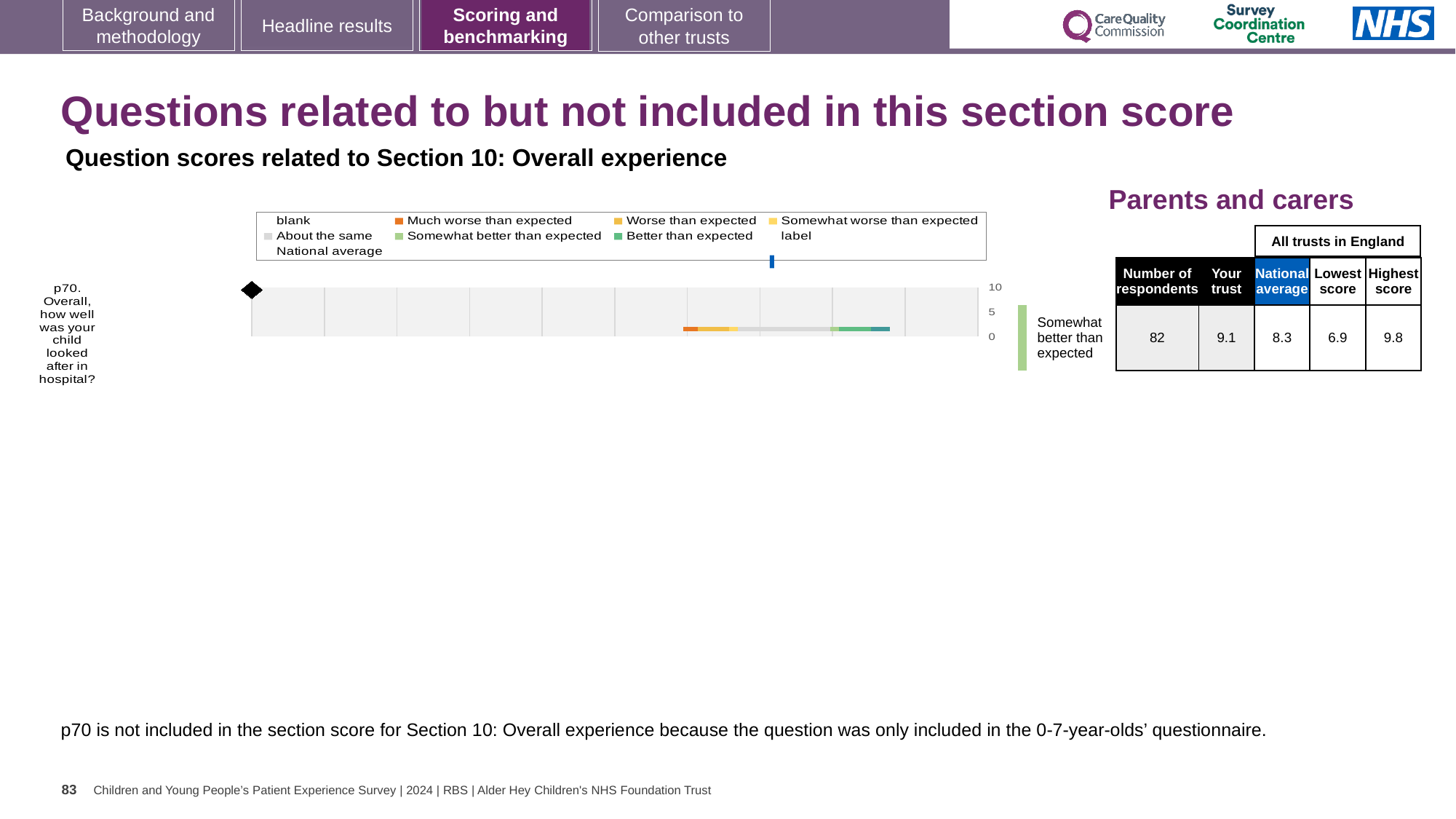
What benchmark category label is shown to the right of the p70 bar? Somewhat better than expected What is the Lowest score across all trusts in England for p70? 6.9 How many survey questions are plotted in the chart? 1 What is the Highest score across all trusts in England for p70? 9.8 What is the 'Your trust' score for p70 in the Parents and carers table? 9.1 How many respondents answered p70 in the Parents and carers table? 82 For p70, what is the difference between the 'Your trust' score and the National average? 0.8 What is the National average score for p70 in the Parents and carers table? 8.3 What kind of chart is shown for question p70? bar chart For p70, which is higher: the 'Your trust' score or the National average? Your trust For p70, what is the difference between the Highest score and the Lowest score across all trusts in England? 2.9 Which survey question is plotted in the chart? p70. Overall, how well was your child looked after in hospital?